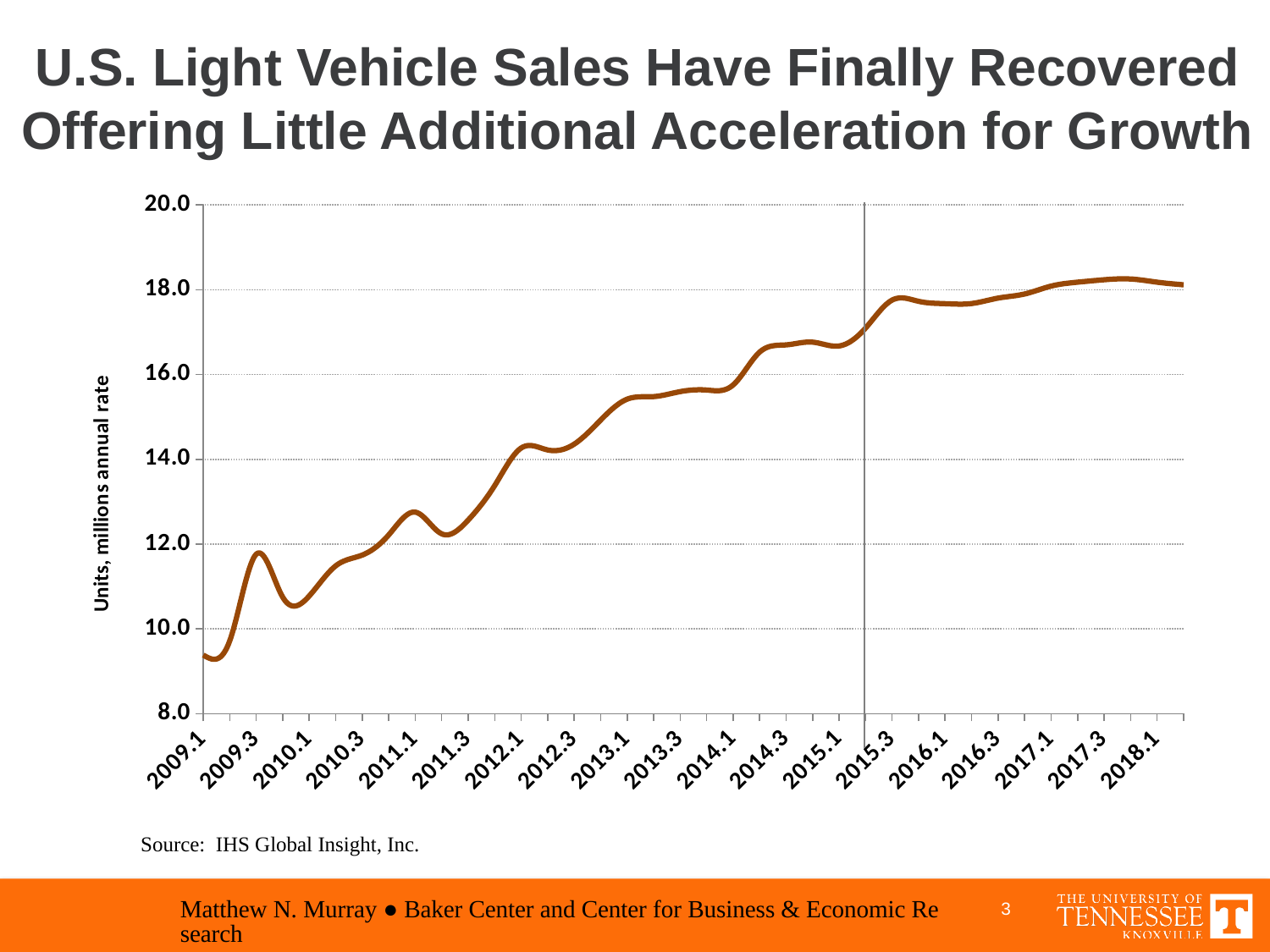
Is the value for 2013.1 greater or less than 16.0? less Is the value for 2014.3 greater or less than 16.0? greater What kind of chart is shown on the slide? line chart What is the label on the vertical axis of the chart? Units, millions annual rate Is the value for 2009.1 greater or less than 10.0? less Overall, do U.S. light vehicle sales rise or fall from 2009.1 to 2018.1? rise Which is larger, the value for 2018.1 or the value for 2009.1? 2018.1 What is the title of the chart on the slide? U.S. Light Vehicle Sales Have Finally Recovered Offering Little Additional Acceleration for Growth Which is larger, the value for 2012.1 or the value for 2010.1? 2012.1